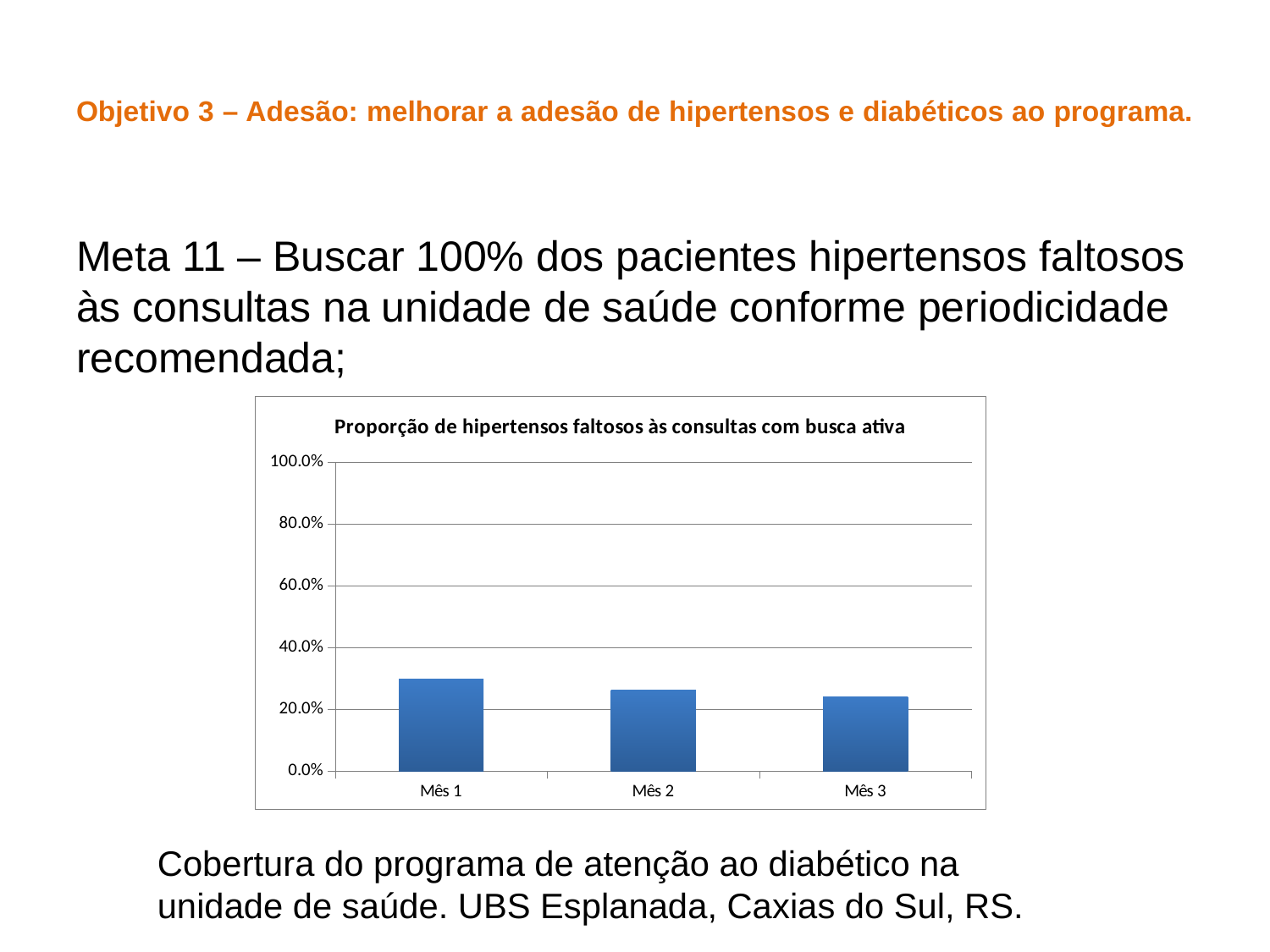
What is the highest value shown on the y axis of the chart? 100.0% Is the value for Mês 1 greater or less than 20%? greater How many categories are shown on the x axis of the chart? 3 Do the values rise or fall from Mês 1 to Mês 3? fall Is the value for Mês 2 greater or less than 40%? less Is the value for Mês 3 greater or less than 20%? greater What is the title of the chart? Proporção de hipertensos faltosos às consultas com busca ativa Which month has the highest value in the chart? Mês 1 Which is larger, the value for Mês 1 or the value for Mês 3? Mês 1 What kind of chart is shown on the slide? bar chart